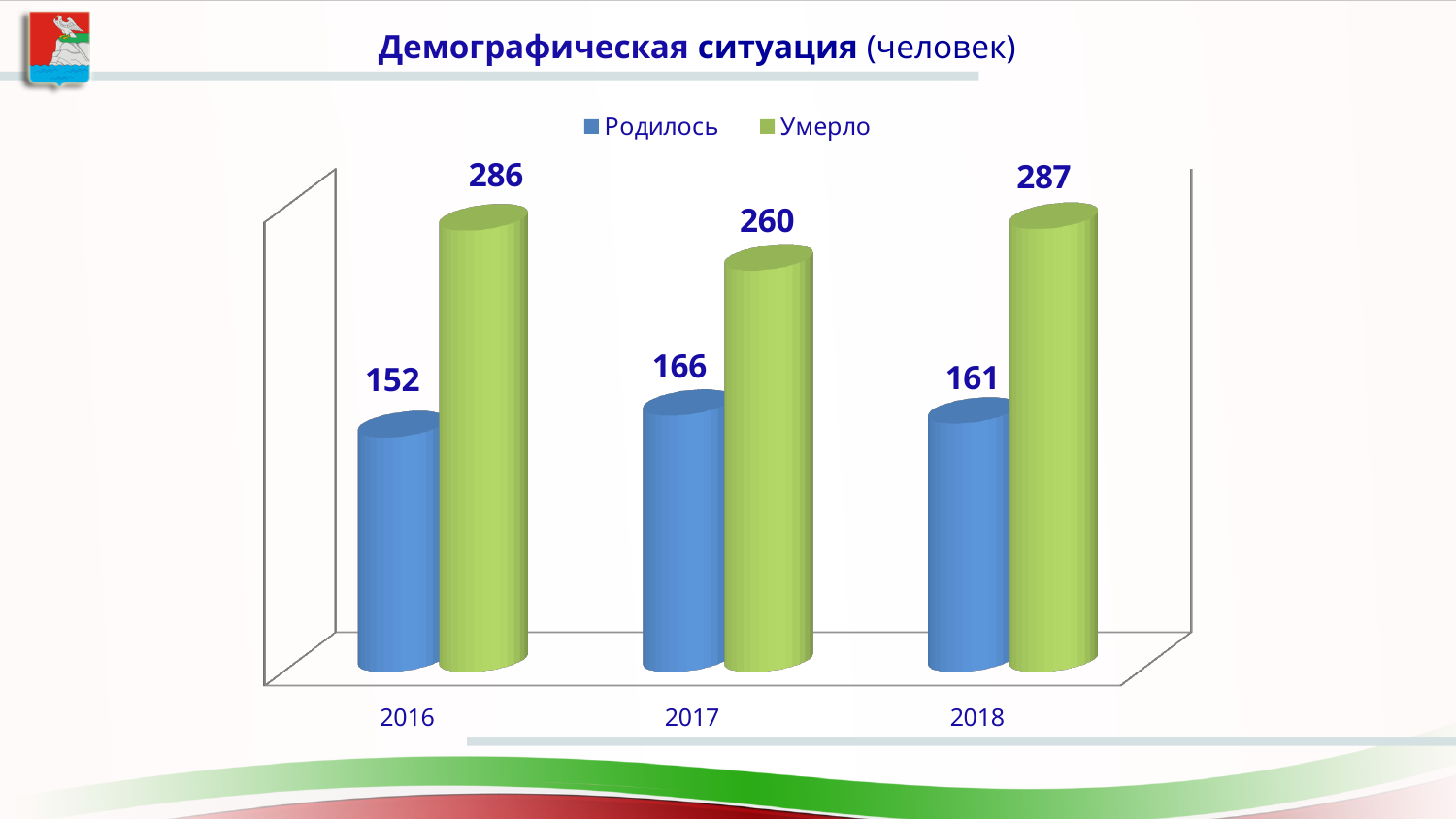
In which year is the Умерло value lowest? 2017 How many series does the legend list? 2 What is the value for Умерло in 2018? 287 What is the value for Родилось in 2016? 152 What is the difference between Умерло and Родилось in 2016? 134 How many years are shown on the x axis? 3 What is the difference between the Умерло values for 2018 and 2017? 27 What is the value for Умерло in 2017? 260 In which year is the Родилось value highest? 2017 What kind of chart is shown on the slide? bar chart What is the title of the chart? Демографическая ситуация (человек) Which is larger in 2018: Родилось or Умерло? Умерло